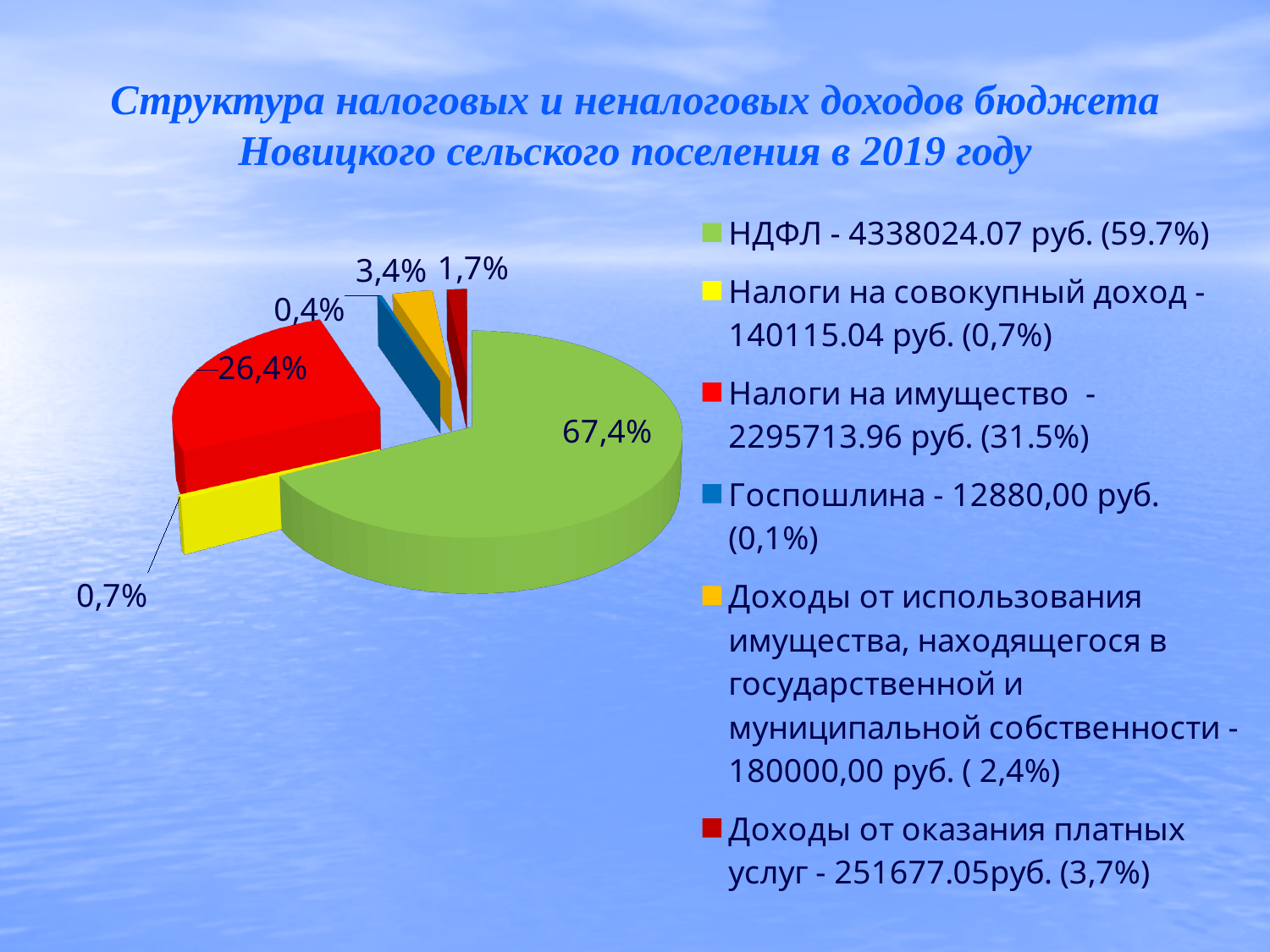
What percentage label is shown on the orange slice for Доходы от использования имущества? 3,4% What type of chart is shown on the slide? Pie chart What percentage label is shown on the red slice for Налоги на имущество? 26,4% What is the difference in percentage points between the НДФЛ slice label and the Налоги на имущество slice label? 41,0% How many slices does the pie chart have? 6 Which category has the smallest slice of the pie chart? Госпошлина What percentage label is shown on the yellow slice for Налоги на совокупный доход? 0,7% Which category has the largest slice of the pie chart? НДФЛ What ruble amount does the legend give for Госпошлина? 12880,00 руб. What percentage label is shown on the green НДФЛ slice of the pie chart? 67,4% How many entries does the legend list? 6 Which slice is larger: Доходы от использования имущества or Доходы от оказания платных услуг? Доходы от использования имущества